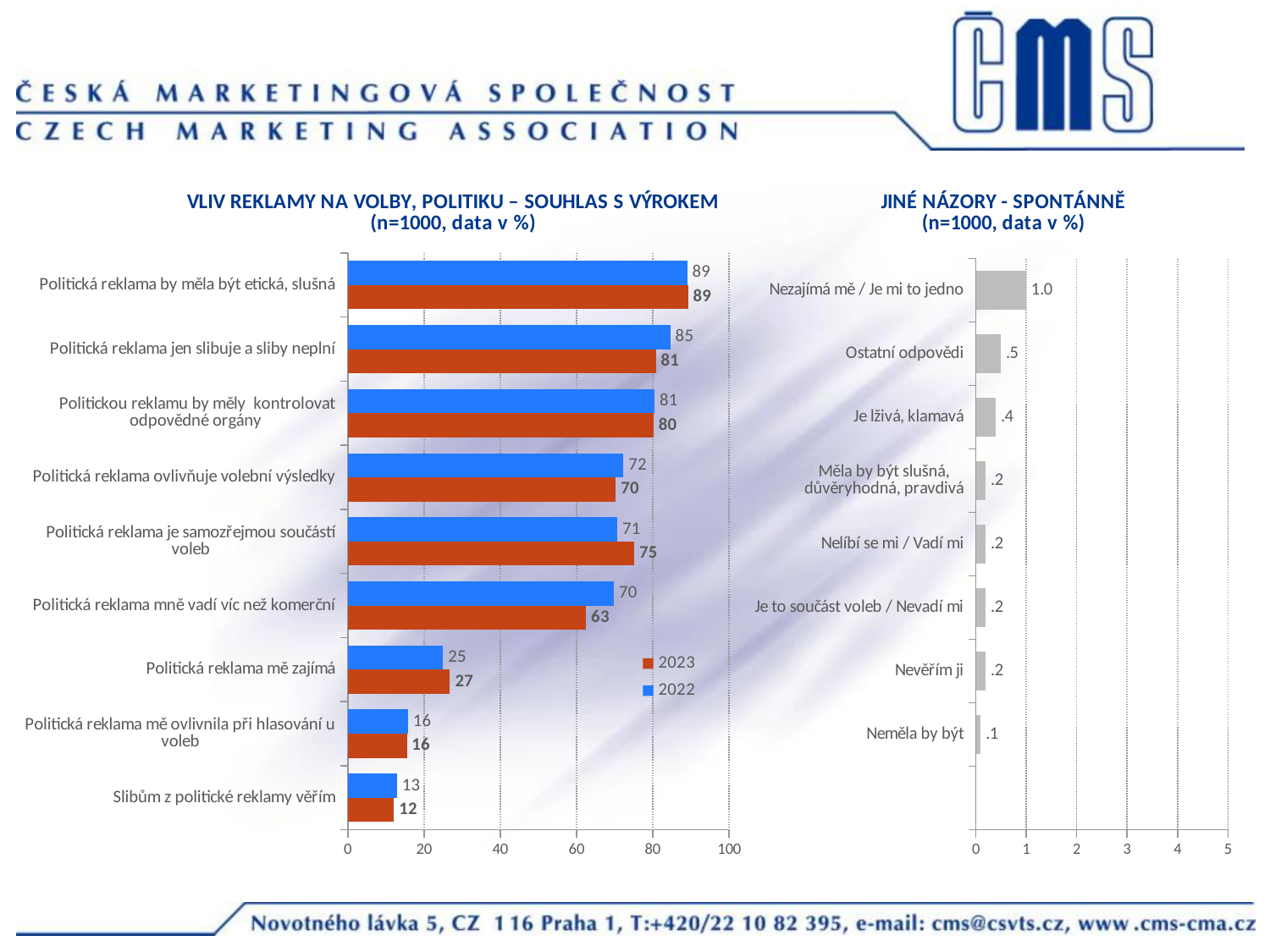
In the chart 'VLIV REKLAMY NA VOLBY, POLITIKU – SOUHLAS S VÝROKEM', for 'Politická reklama je samozřejmou součástí voleb', which year has the larger value, 2022 or 2023? 2023 In the chart 'VLIV REKLAMY NA VOLBY, POLITIKU – SOUHLAS S VÝROKEM', which colour represents the 2023 series? Orange (red-orange) How many statements (categories) are shown in the chart 'VLIV REKLAMY NA VOLBY, POLITIKU – SOUHLAS S VÝROKEM'? 9 In the chart 'VLIV REKLAMY NA VOLBY, POLITIKU – SOUHLAS S VÝROKEM', what is the 2022 value for 'Politická reklama mně vadí víc než komerční'? 70 In the chart 'VLIV REKLAMY NA VOLBY, POLITIKU – SOUHLAS S VÝROKEM', what is the 2023 value for 'Politická reklama jen slibuje a sliby neplní'? 81 In the chart 'JINÉ NÁZORY - SPONTÁNNĚ', which category has the lowest value? Neměla by být In the chart 'VLIV REKLAMY NA VOLBY, POLITIKU – SOUHLAS S VÝROKEM', which statement has the highest 2022 value? Politická reklama by měla být etická, slušná What kind of chart is 'JINÉ NÁZORY - SPONTÁNNĚ'? Bar chart In the chart 'VLIV REKLAMY NA VOLBY, POLITIKU – SOUHLAS S VÝROKEM', which statement has the lowest 2023 value? Slibům z politické reklamy věřím In the chart 'VLIV REKLAMY NA VOLBY, POLITIKU – SOUHLAS S VÝROKEM', what is the difference between the 2022 and 2023 values for 'Politická reklama mně vadí víc než komerční'? 7 How many series does the legend of the chart 'VLIV REKLAMY NA VOLBY, POLITIKU – SOUHLAS S VÝROKEM' list? 2 In the chart 'JINÉ NÁZORY - SPONTÁNNĚ', what is the value for 'Nezajímá mě / Je mi to jedno'? 1.0